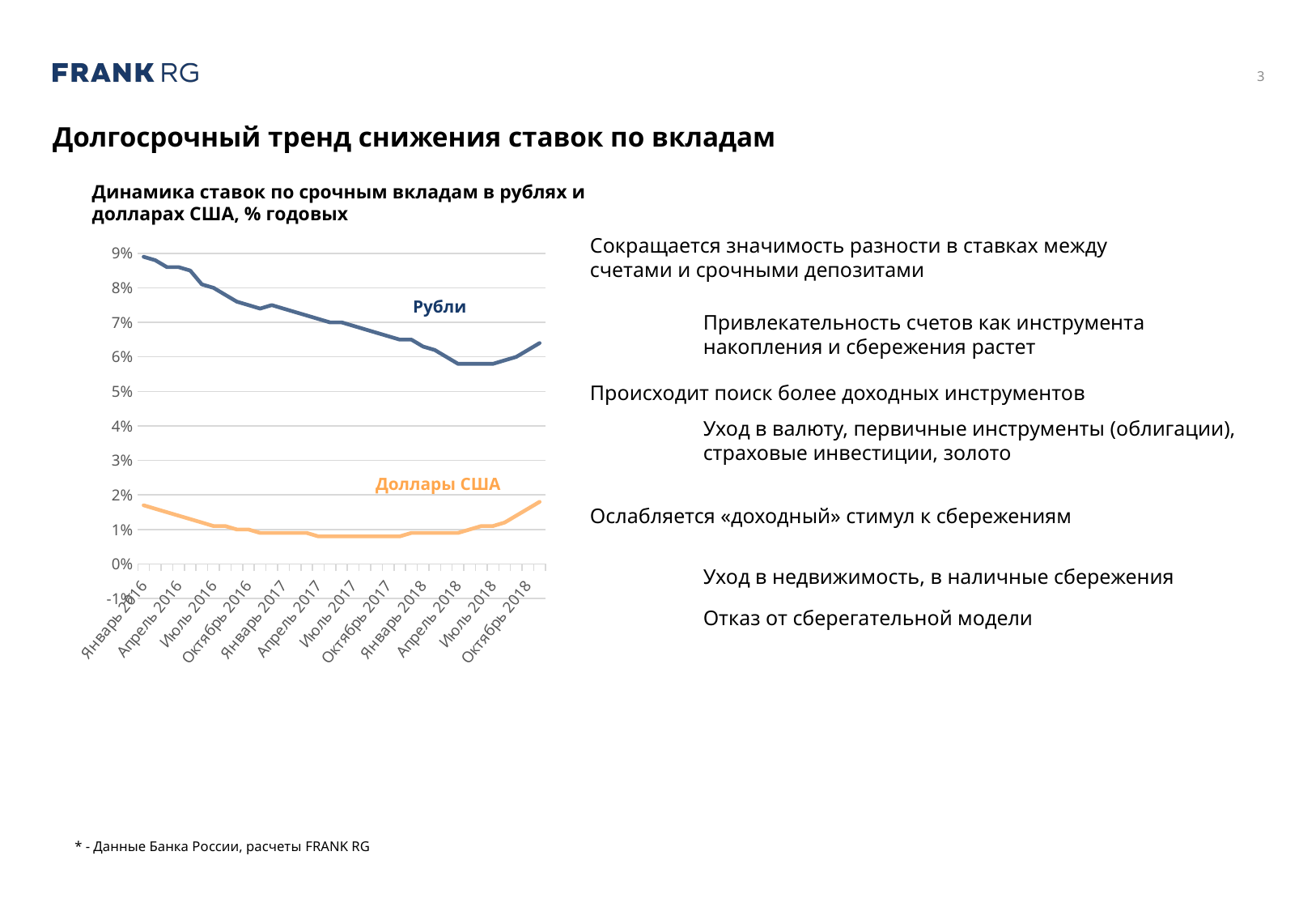
Is the value for Доллары США in Июль 2017 greater or less than 2%? less Is the value for Рубли in Апрель 2018 greater or less than 7%? less Is the value for Рубли in Январь 2016 greater or less than 8%? greater What kind of chart is shown on the slide? line chart What is the title of the chart? Динамика ставок по срочным вкладам в рублях и долларах США, % годовых Which series has higher values throughout the chart, Рубли or Доллары США? Рубли What are the names of the two series plotted on the chart? Рубли and Доллары США Which series is drawn in orange? Доллары США How many series are plotted on the chart? 2 Do the values for Рубли generally rise or fall from Январь 2016 to Апрель 2018? fall